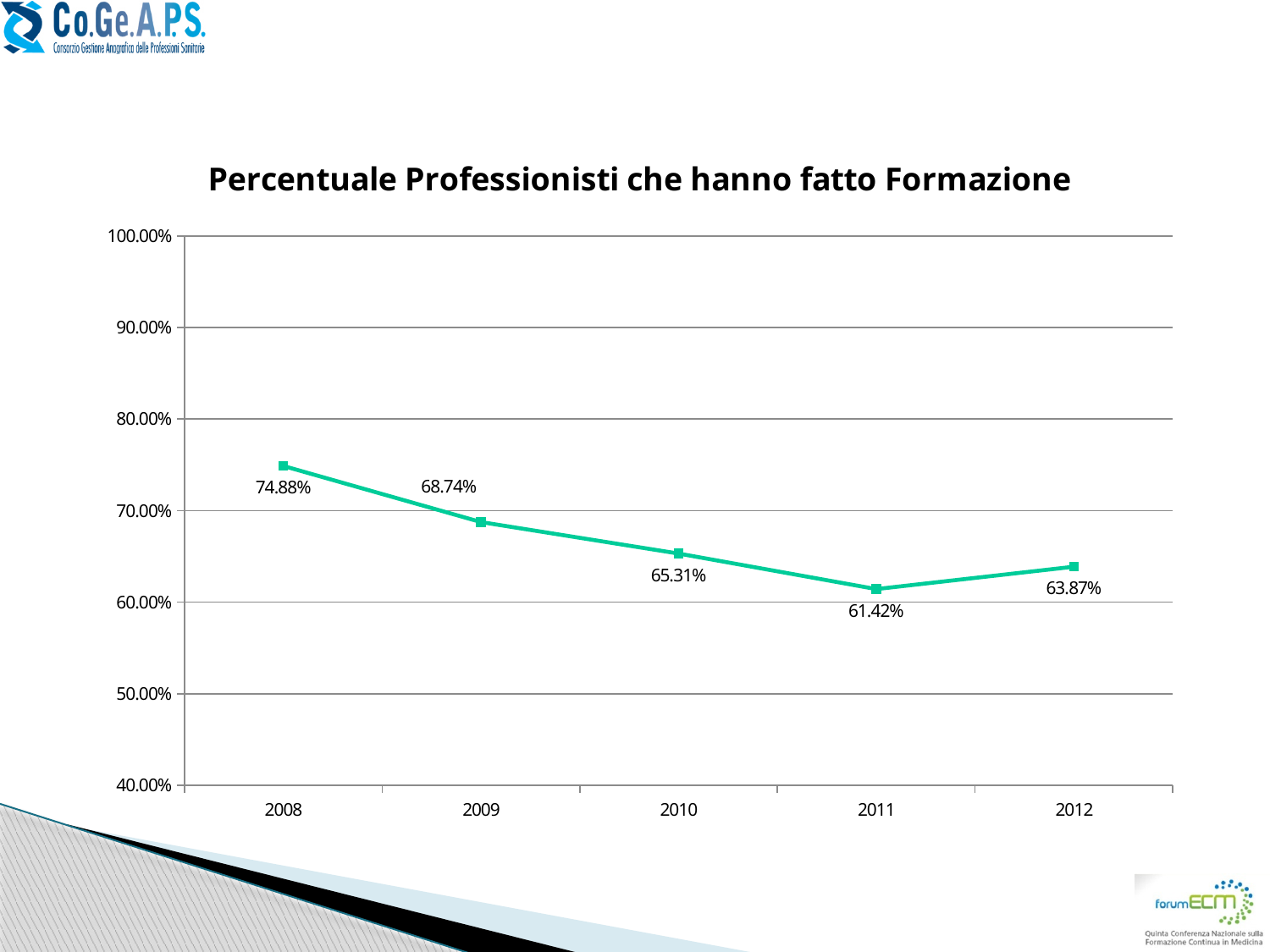
What is the title of the chart? Percentuale Professionisti che hanno fatto Formazione Which is larger, the value for 2010 or the value for 2012? 2010 What is the difference between the values for 2012 and 2011? 2.45% Is the value for 2009 greater or less than 70.00%? less What is the value for 2012? 63.87% How many years are plotted on the chart? 5 Which year has the lowest value? 2011 Which year has the highest value? 2008 What is the difference between the values for 2008 and 2009? 6.14% What is the value for 2011? 61.42% What is the value for 2008? 74.88% What kind of chart is shown on the slide? line chart